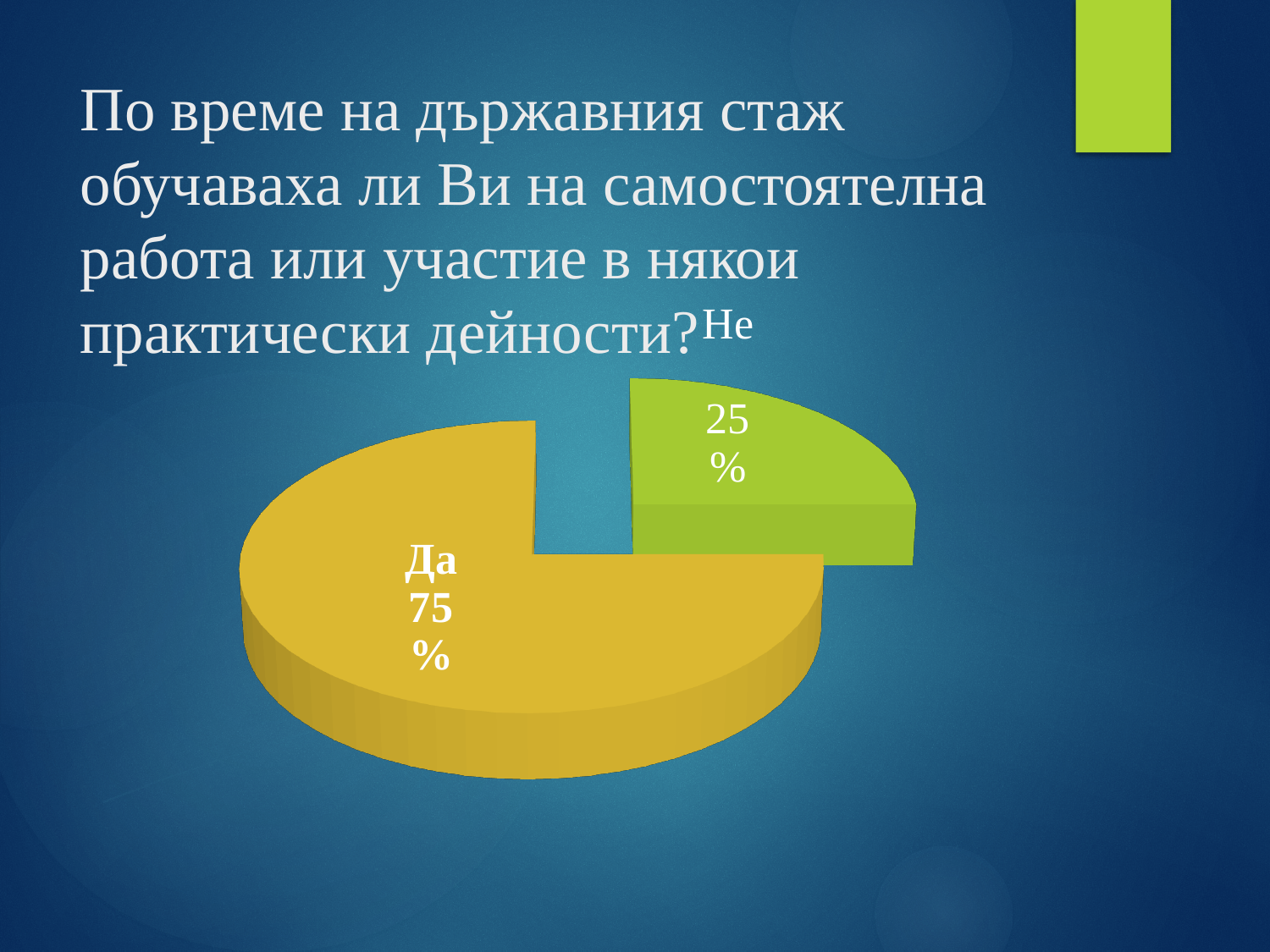
What colour is the "Не" slice? green Which is larger, the "Да" slice or the "Не" slice? Да What share of the pie does the "Не" slice represent? 25% What is the difference in percentage points between the "Да" and "Не" slices? 50 What colour is the "Да" slice? yellow How many slices does the pie chart have? 2 What kind of chart is shown on the slide? pie chart What share of the pie does the "Да" slice represent? 75% Which slice of the pie is the largest? Да Which slice of the pie is the smallest? Не